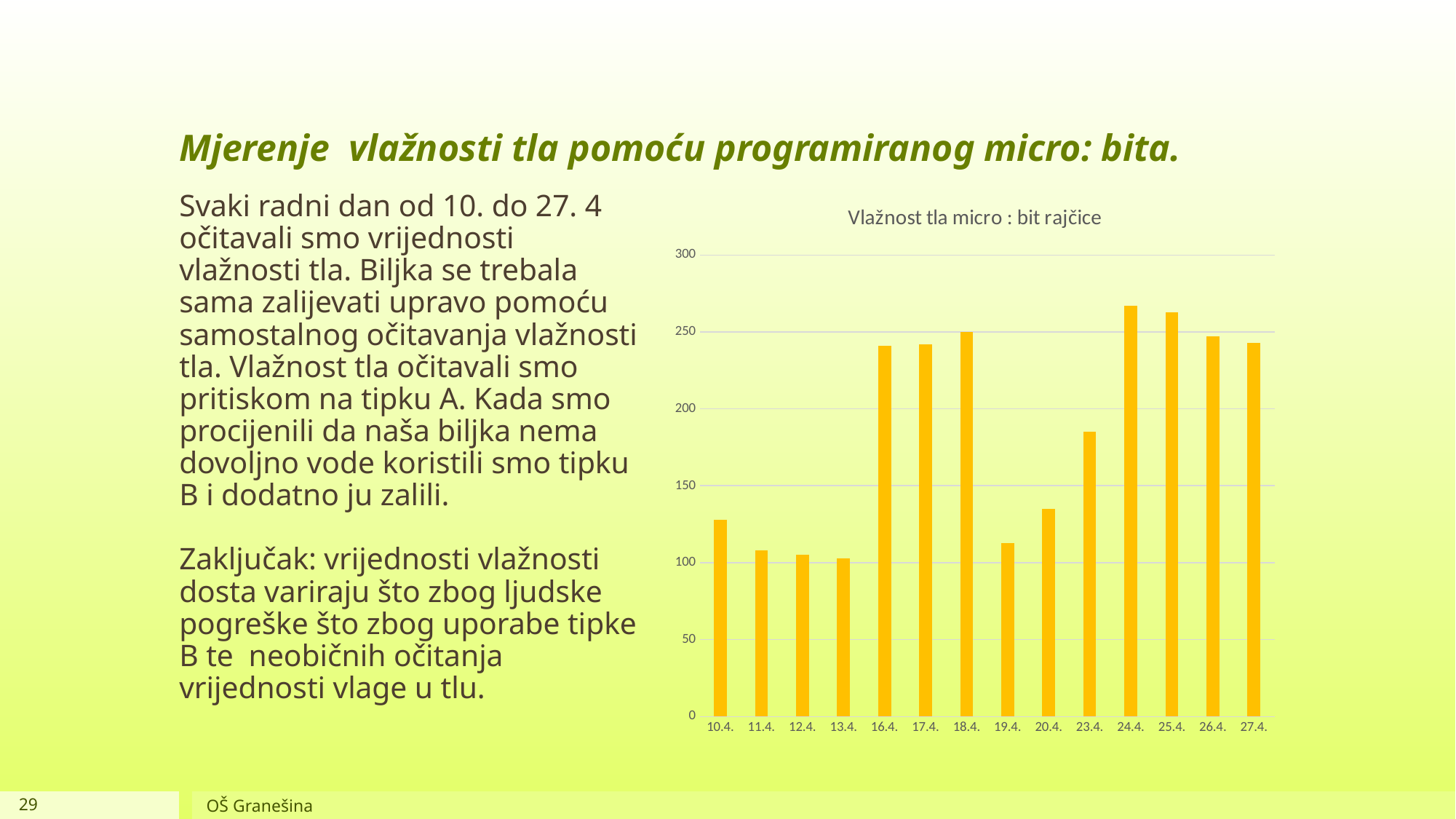
What kind of chart is shown on the slide? bar chart Do the values rise or fall from 10.4. to 13.4.? fall What is the title of the chart? Vlažnost tla micro : bit rajčice How many dates are plotted on the x axis of the chart? 14 Is the value for 23.4. greater or less than 200? less Is the value for 10.4. greater or less than 100? greater Is the value for 16.4. greater or less than 200? greater Which has the larger value, 16.4. or 10.4.? 16.4. Which has the larger value, 23.4. or 20.4.? 23.4.